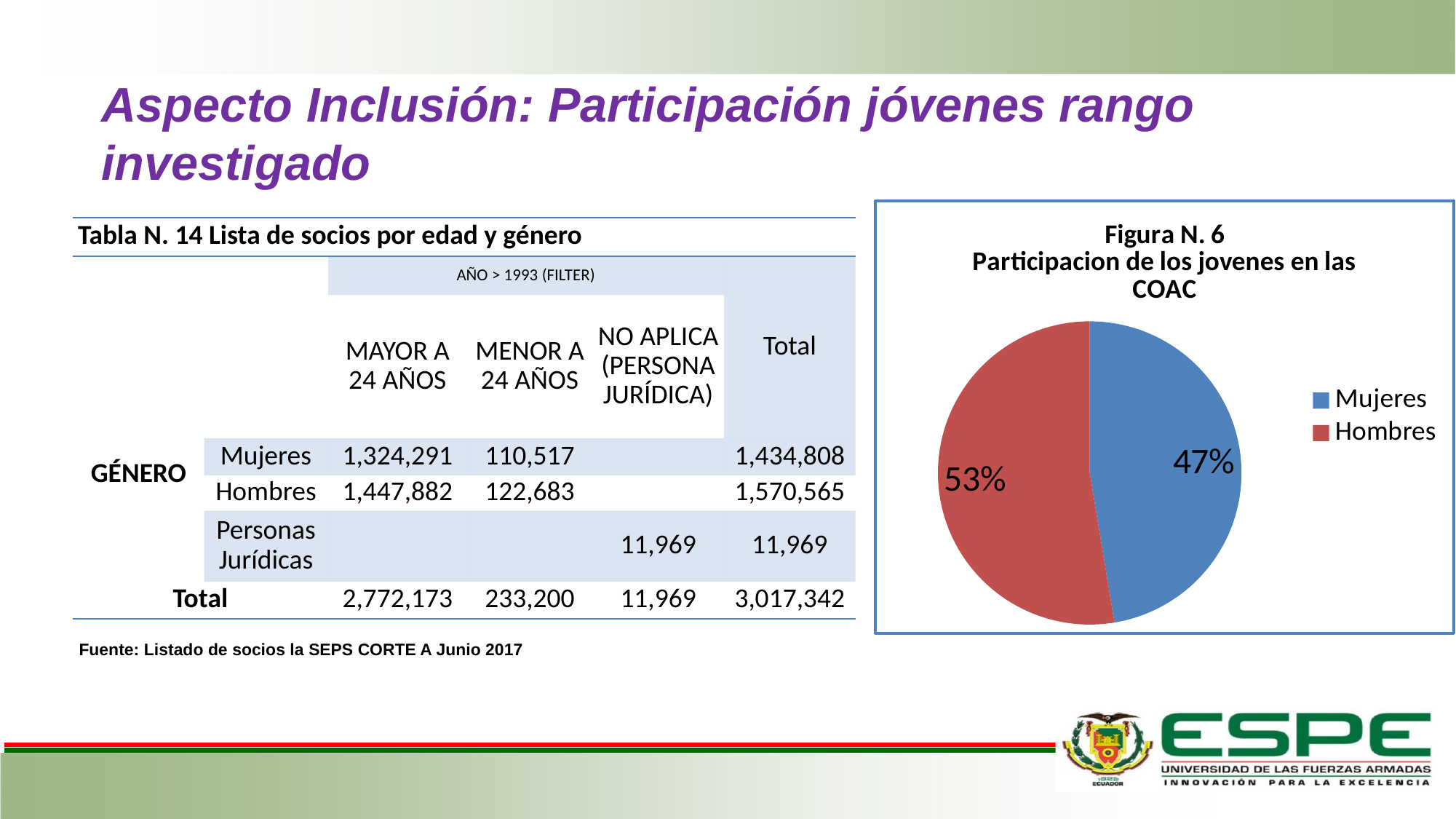
What is the title of the pie chart? Figura N. 6 Participacion de los jovenes en las COAC What is the difference in percentage points between the Hombres and Mujeres slices of the pie chart? 6 What kind of chart is Figura N. 6? pie chart Which slice of the pie chart is the largest? Hombres In the pie chart, what share is shown for Mujeres? 47% In the pie chart, which is larger, the share for Mujeres or the share for Hombres? Hombres Which slice of the pie chart is the smallest? Mujeres Is the share for Mujeres in the pie chart greater or less than 50%? less What colour is the Hombres slice in the pie chart? red How many entries does the legend of the pie chart list? 2 How many slices does the pie chart have? 2 In the pie chart, what share is shown for Hombres? 53%